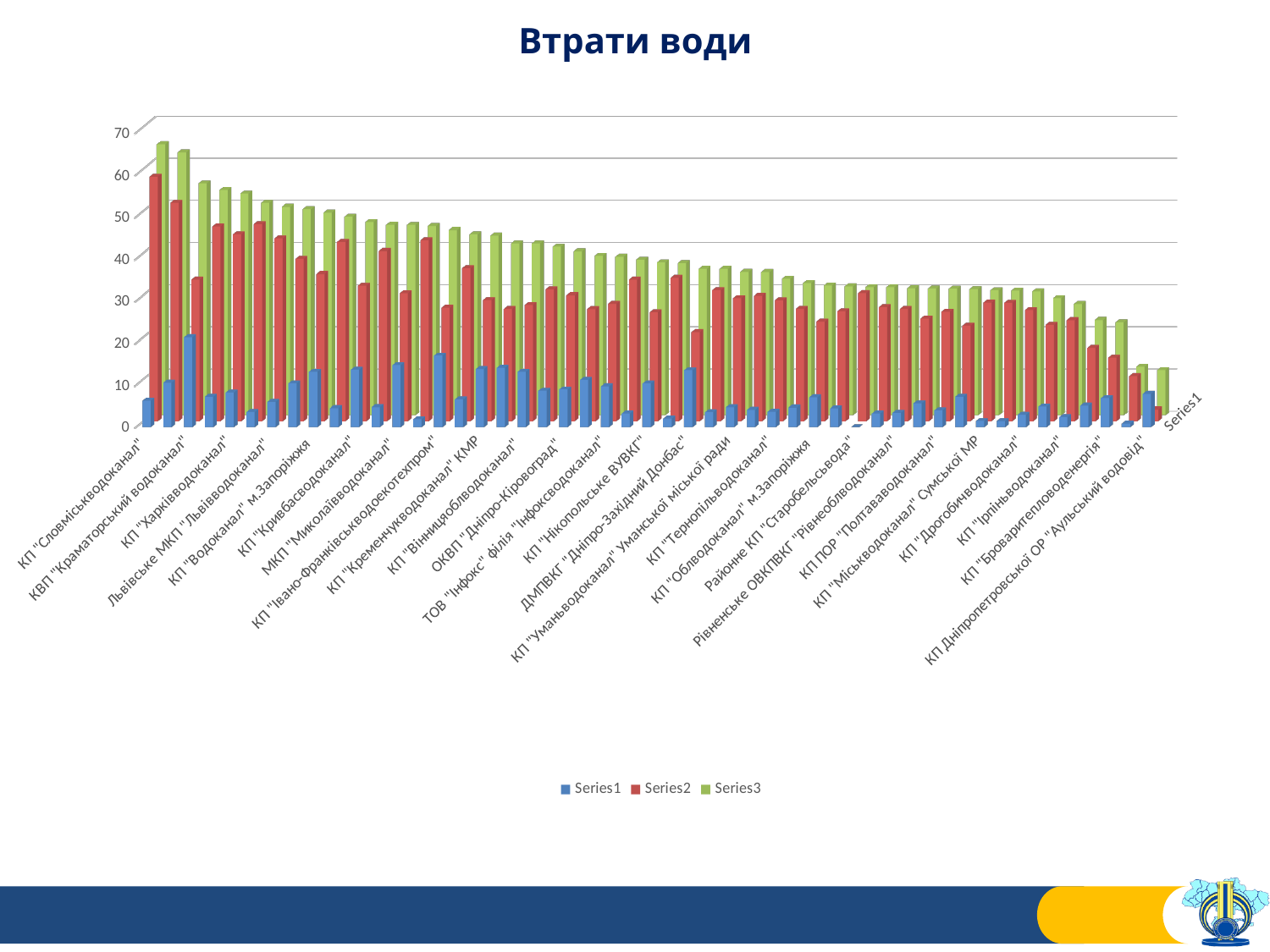
Is the Series1 value for КП "Словміськводоканал" greater or less than 10? less Which category has the highest Series3 value? КП "Словміськводоканал" How many series does the legend list? 3 What are the names of the series in the legend? Series1, Series2, Series3 Is the Series2 value for КП "Словміськводоканал" greater or less than 50? greater Is the Series3 value for КП "Словміськводоканал" greater or less than 60? greater What is the title of the chart? Втрати води What kind of chart is shown on the slide? bar chart Do the Series3 values generally rise or fall from left to right along the x axis? fall Which series has the tallest bar on the chart? Series3 For КП "Словміськводоканал", which is larger: the Series1 value or the Series3 value? Series3